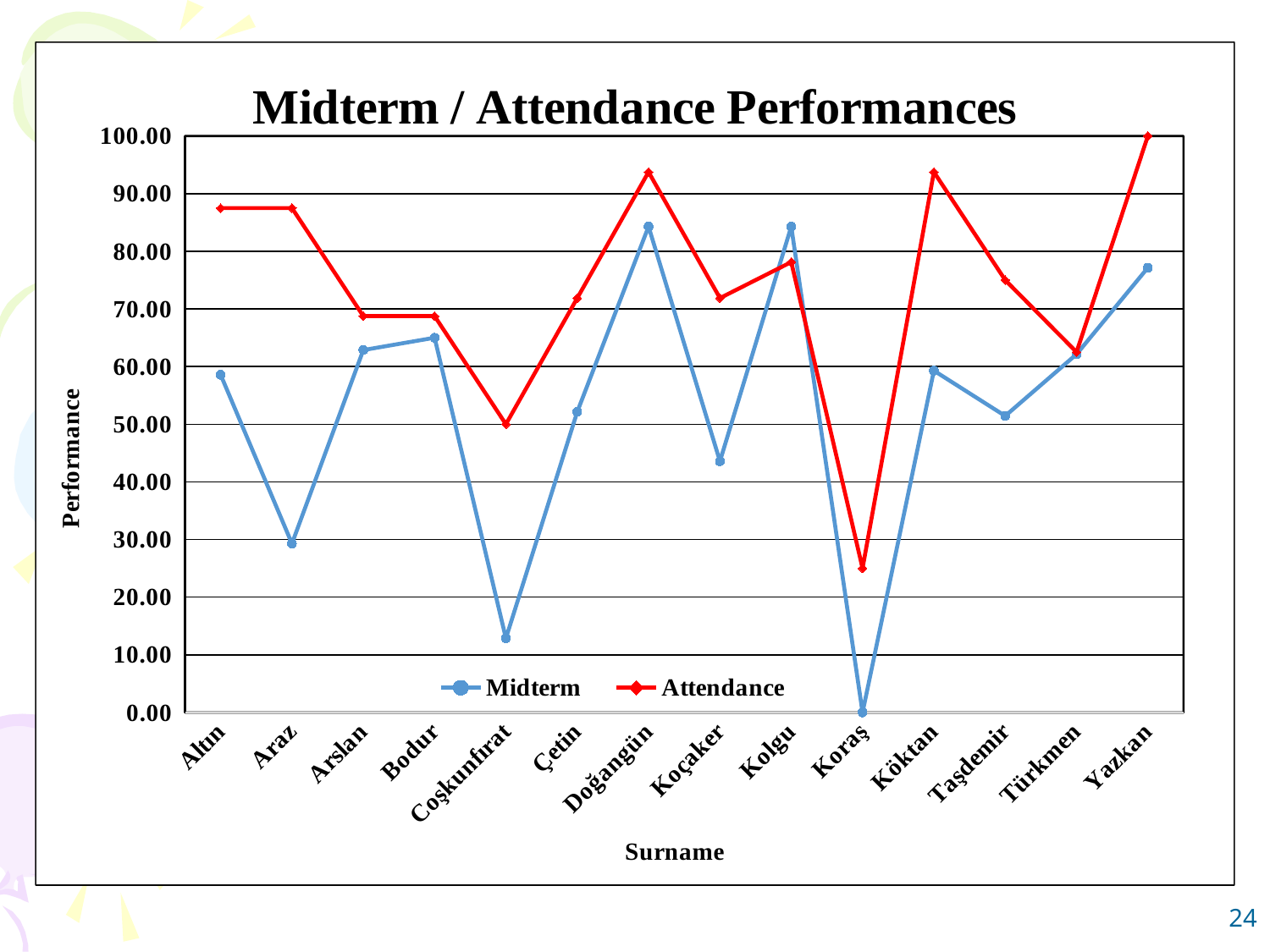
For Altın, which is larger: the Midterm value or the Attendance value? Attendance Which surname has the lowest Midterm value? Koraş Is the Attendance value for Köktan greater or less than 90.00? greater Which surname has the highest Attendance value? Yazkan How many series does the legend list? 2 Which surname has the lowest Attendance value? Koraş What is the Attendance value for Yazkan? 100.00 What kind of chart is shown on the slide? Line chart What is the Midterm value for Koraş? 0.00 Is the Midterm value for Coşkunfırat greater or less than 20.00? less What is the title of the chart? Midterm / Attendance Performances How many surnames are plotted along the x axis? 14